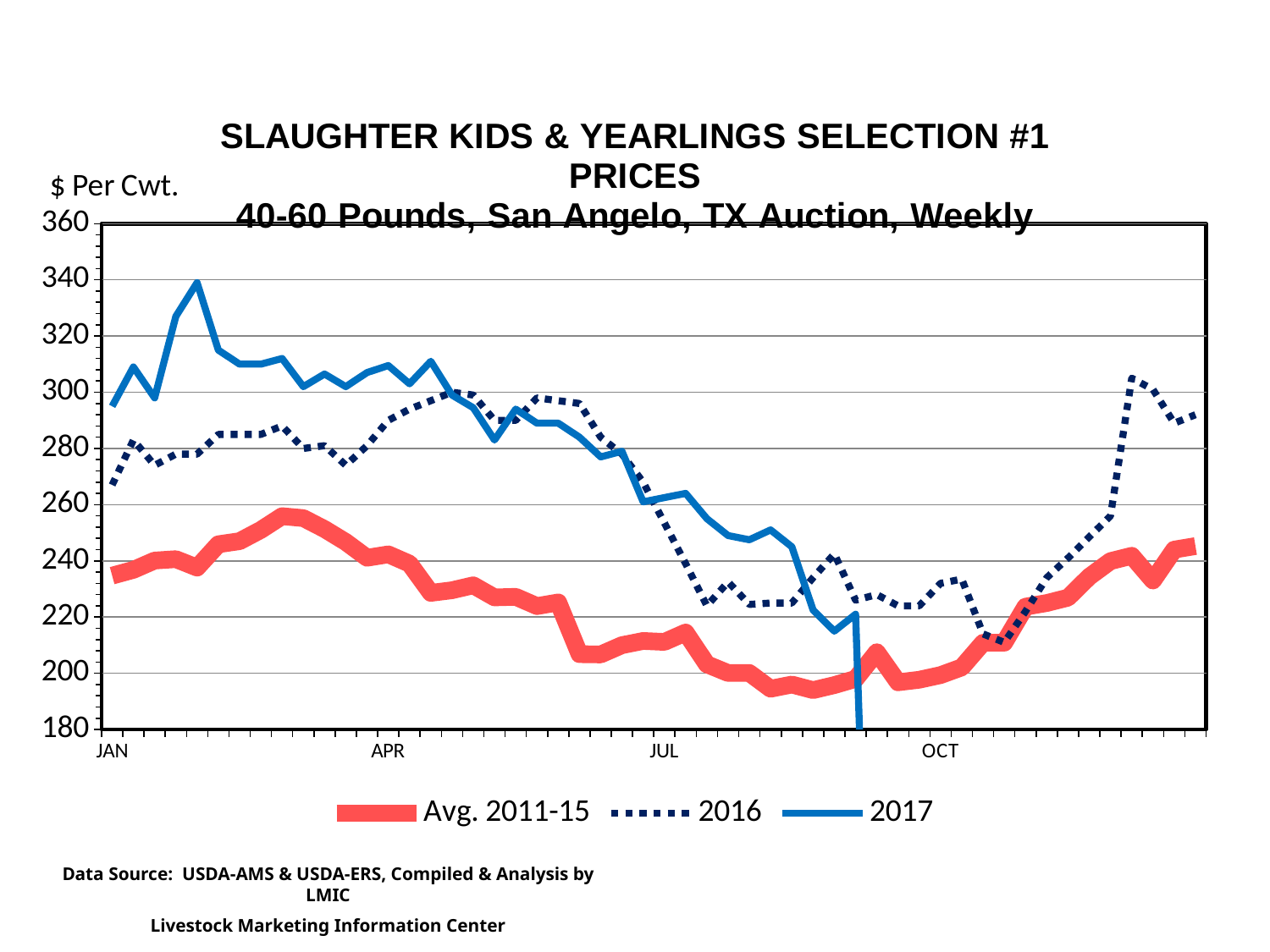
What kind of chart is shown on the slide? line chart At JAN, which is higher: the 2017 series or the Avg. 2011-15 series? 2017 At JUL, which is higher: the 2016 series or the Avg. 2011-15 series? 2016 Which series reaches the highest value on the chart? 2017 Which series is drawn as a dotted line? 2016 Is the value of the Avg. 2011-15 series at JAN greater or less than 260? less How many series does the legend list? 3 Does the Avg. 2011-15 series rise or fall from APR to JUL? fall What unit is shown on the y-axis label? $ Per Cwt. Is the highest value of the 2017 line greater or less than 320? greater Is the value of the 2017 series at JAN greater or less than 280? greater